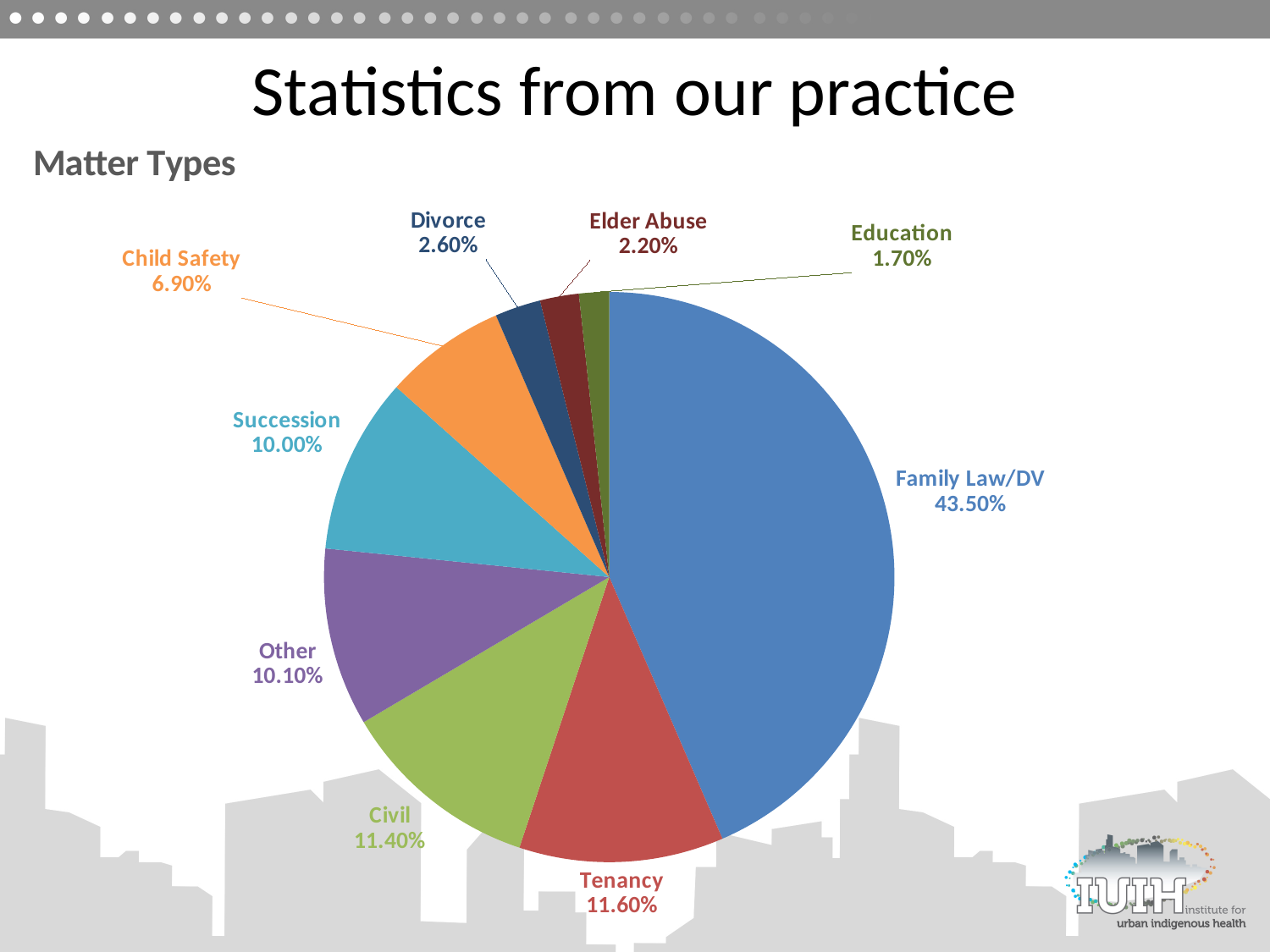
What colour is the Tenancy slice? red What is the difference between the Family Law/DV and Child Safety percentages? 36.60% What is the title of the chart? Matter Types What type of chart is shown on the slide? pie chart How many matter types are shown in the pie chart? 9 Which matter type has the largest share of the pie? Family Law/DV Which is larger, the share for Other or the share for Succession? Other What is the difference between the Tenancy and Civil percentages? 0.20% What percentage of matters is Succession? 10.00% Which matter type has the smallest share of the pie? Education What percentage of matters is Family Law/DV? 43.50% What percentage of matters is Elder Abuse? 2.20%